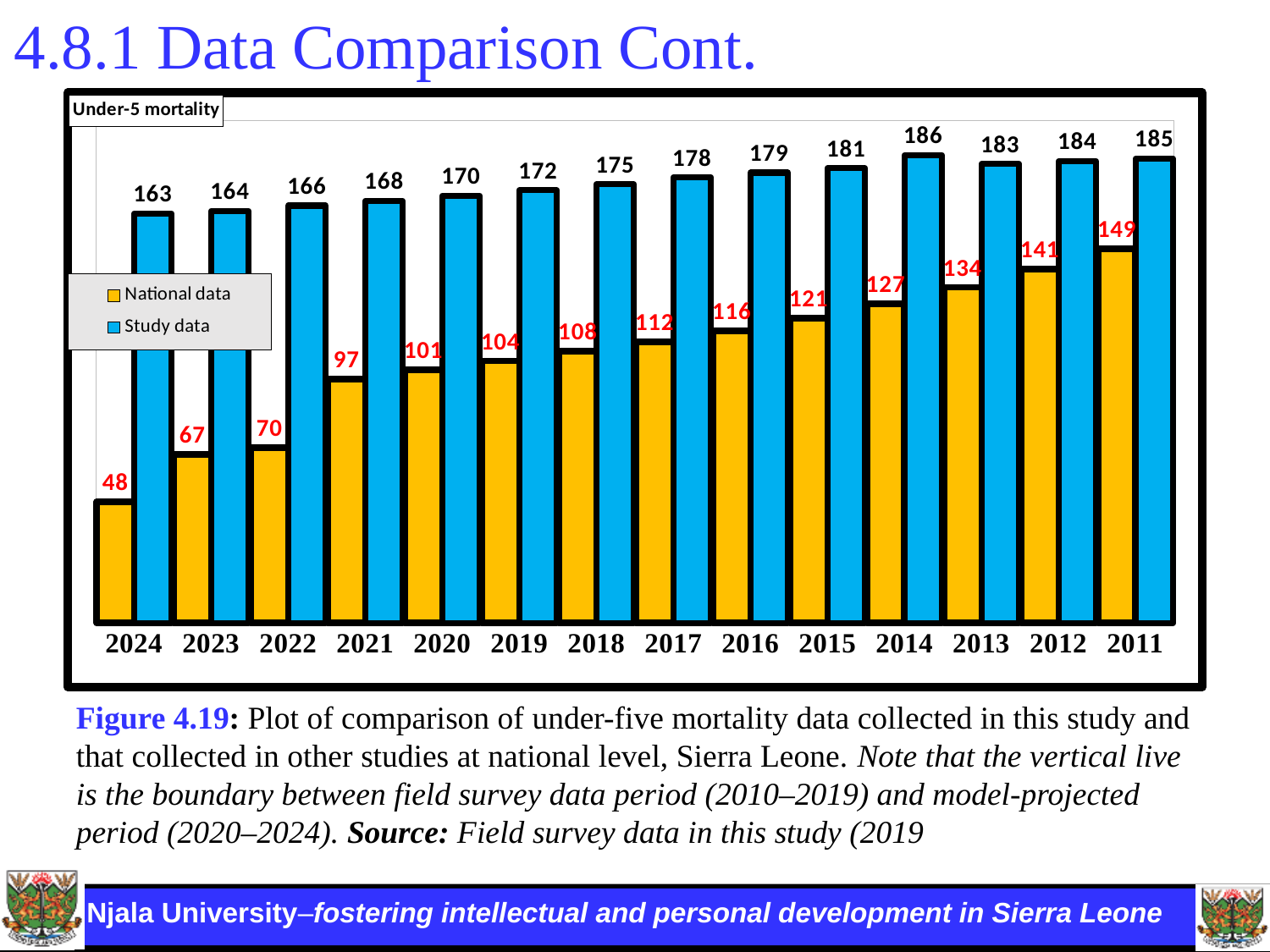
Which year has the lowest National data value? 2024 What is the difference between the Study data and National data values for 2024? 115 What is the Study data value for 2024? 163 How many years are shown on the x axis? 14 What is the National data value for 2020? 101 What kind of chart is shown on the slide? Bar chart What is the difference between the National data values for 2011 and 2012? 8 Do the National data values rise or fall moving from 2024 on the left to 2011 on the right? Rise How many series does the legend list? 2 Which is larger, the National data value for 2021 or for 2022? 2021 Which year has the highest Study data value? 2014 What is the National data value for 2011? 149